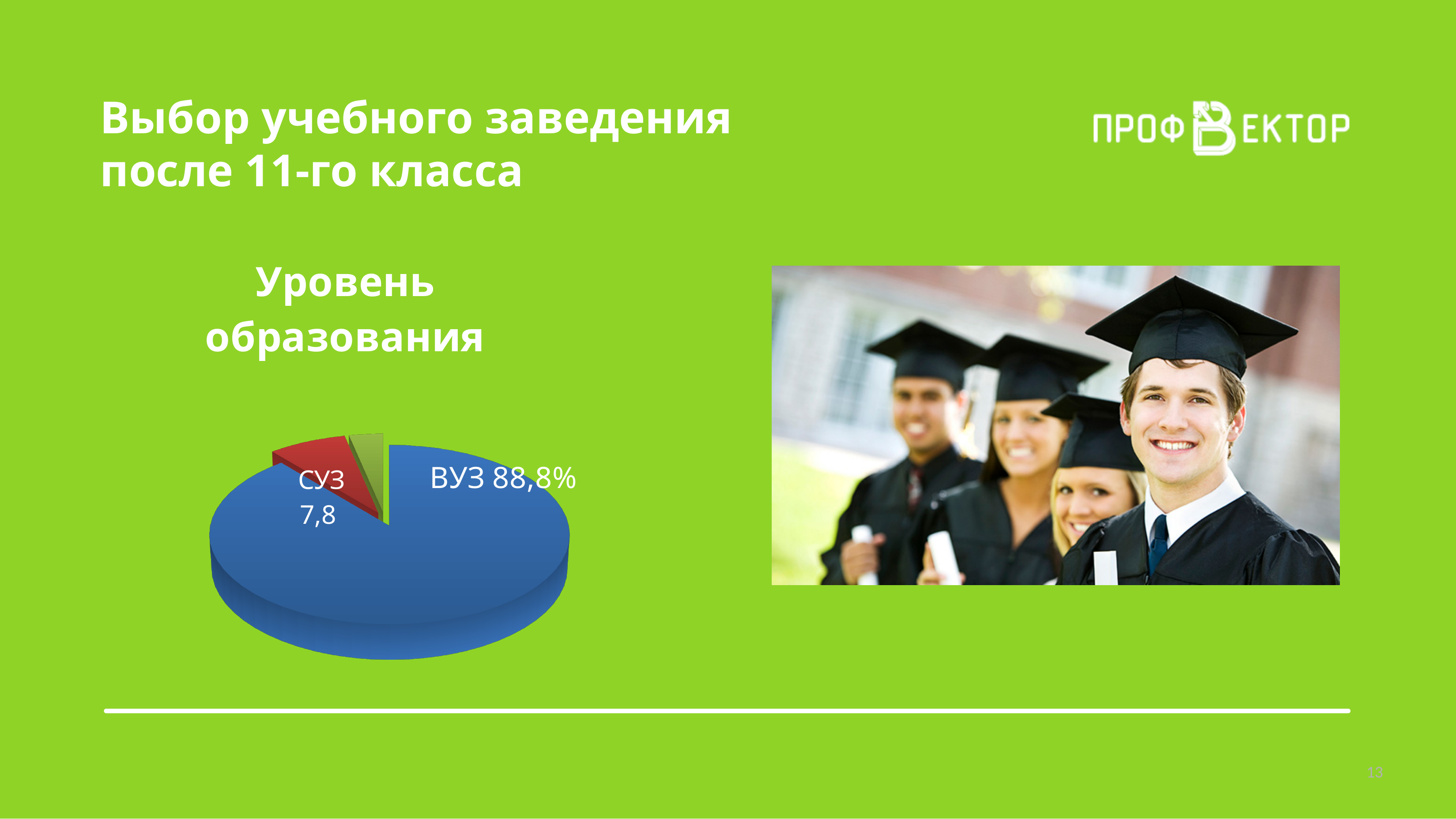
Which category has the largest slice of the pie? ВУЗ What value is shown for СУЗ in the pie chart? 7,8 How many slices does the pie chart have? 3 Which is larger, the slice for ВУЗ or the slice for СУЗ? ВУЗ What kind of chart is shown on the slide? pie chart What is the title of the chart on the slide? Уровень образования By how much does the ВУЗ value exceed the СУЗ value? 81 What share of the pie does ВУЗ have? 88,8% What colour is the ВУЗ slice in the pie chart? blue